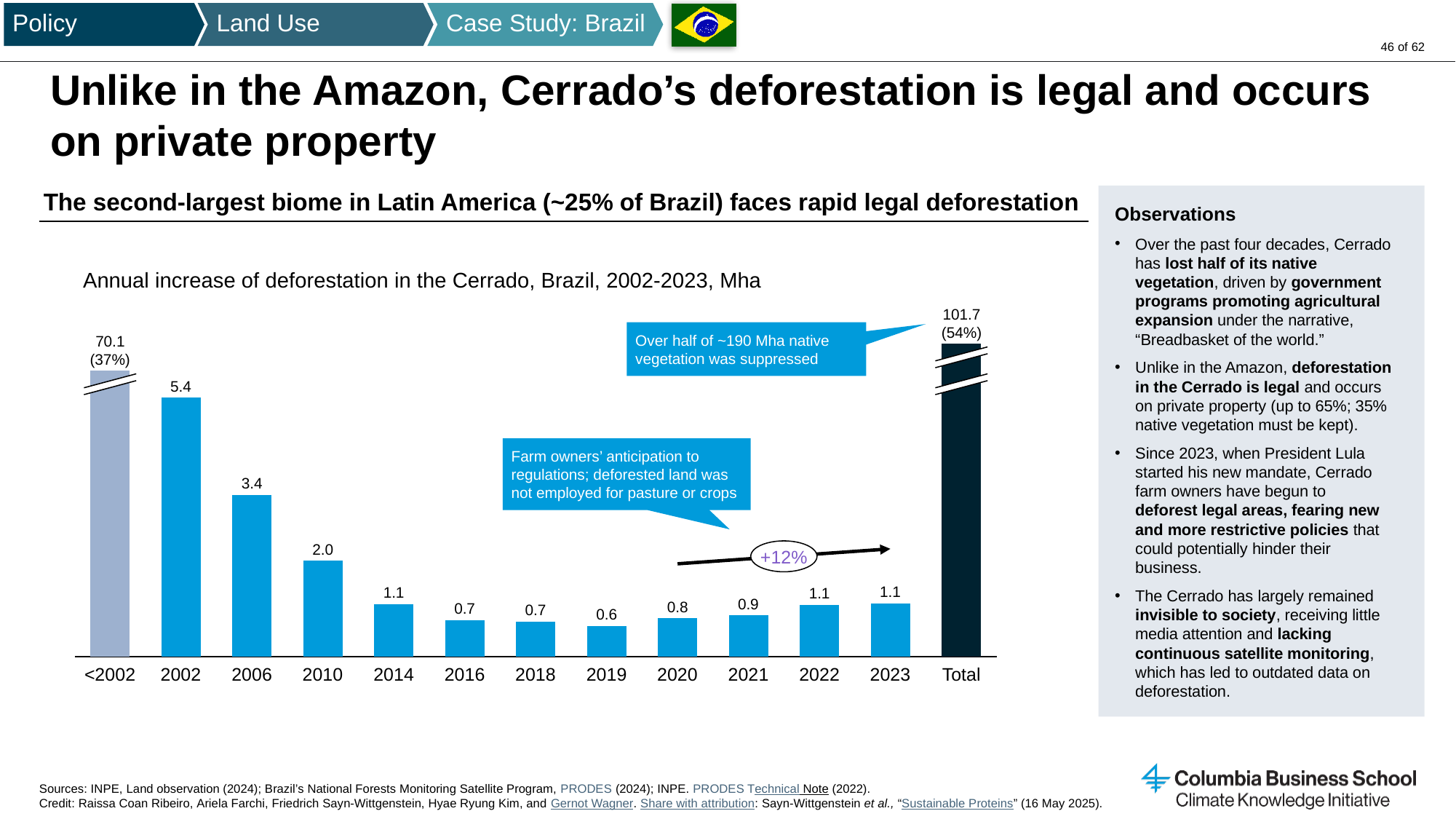
What is the value for 2019? 0.6 Which is larger, the value for 2010 or the value for 2021? 2010 What kind of chart is this? Bar chart What is the value for 2002? 5.4 What is the value for the Total bar? 101.7 Do the values rise or fall from 2019 to 2023? Rise What is the difference between the values for 2002 and 2006? 2.0 What percentage is shown next to the Total bar? 54% Which category has the highest value? Total What is the value for the <2002 bar? 70.1 Which year between 2002 and 2023 has the lowest value? 2019 How many categories are shown on the x axis? 13